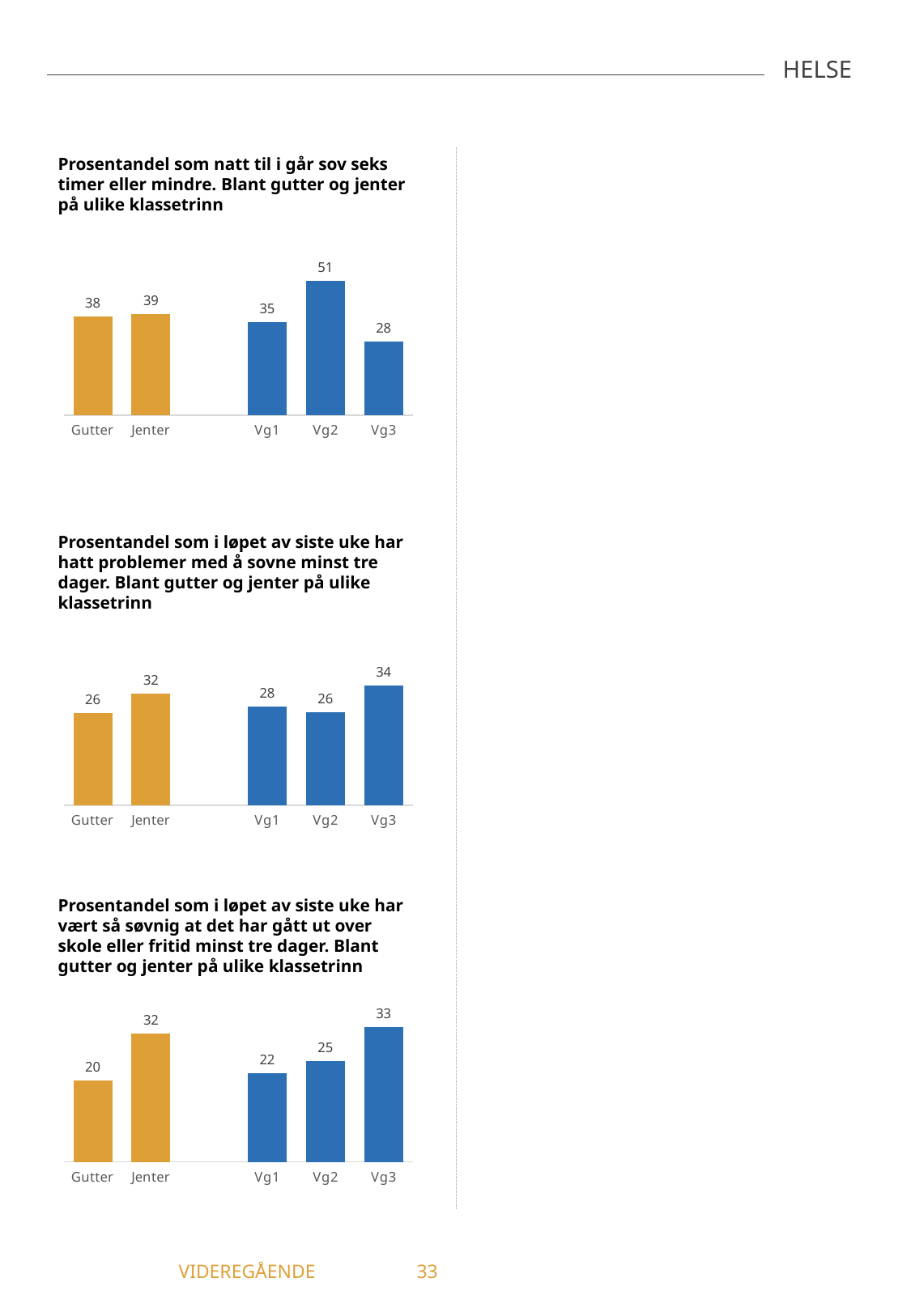
In the bottom chart (so sleepy it affected school or leisure), do the values rise or fall from Vg1 to Vg3? rise What type of chart is the bottom chart? bar chart In the middle chart (problems falling asleep), what is the difference between Jenter and Gutter? 6 In the middle chart (problems falling asleep), which category has the highest value? Vg3 In the bottom chart (so sleepy it affected school or leisure), which is larger, Vg1 or Vg2? Vg2 In the middle chart (problems falling asleep), what is the value for Jenter? 32 In the top chart (sleeping six hours or less), which category has the lowest value? Vg3 In the top chart, what colour are the Gutter and Jenter bars? orange In the top chart (sleeping six hours or less), what is the value for Vg2? 51 In the top chart (sleeping six hours or less), what is the difference between Vg2 and Vg3? 23 In the bottom chart (so sleepy it affected school or leisure), what is the value for Gutter? 20 In the top chart (sleeping six hours or less), how many bars are shown? 5